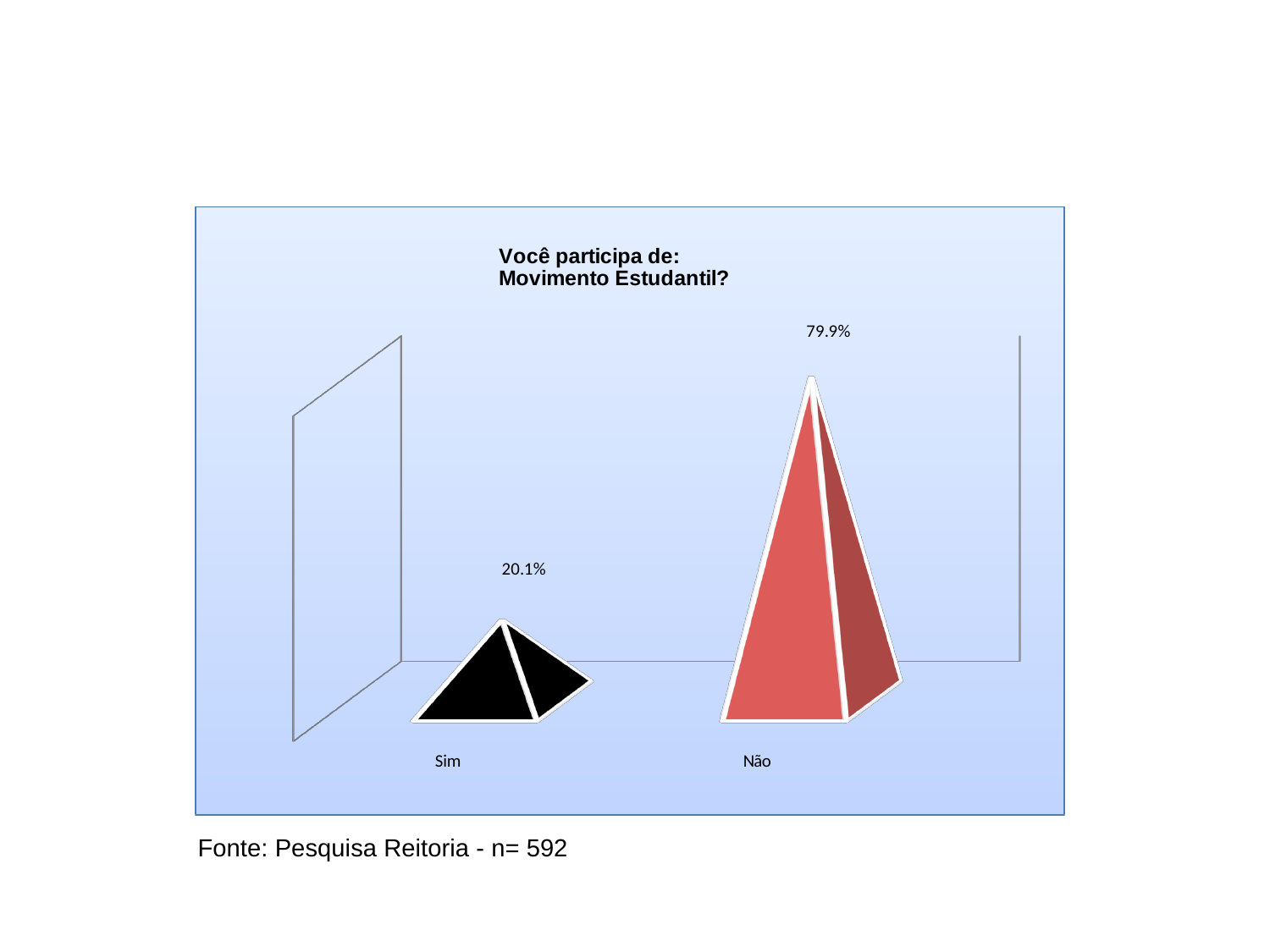
Which category has the highest value? Não Which is larger, the value for Sim or the value for Não? Não What is the title of the chart? Você participa de: Movimento Estudantil? What is the value for Sim? 20.1% What is the total of the values for Sim and Não? 100% What is the difference between the values for Não and Sim? 59.8% Which category has the lowest value? Sim What colour is the bar for Não? Red How many categories are shown in the chart? 2 What is the value for Não? 79.9% What kind of chart is shown on the slide? Bar chart